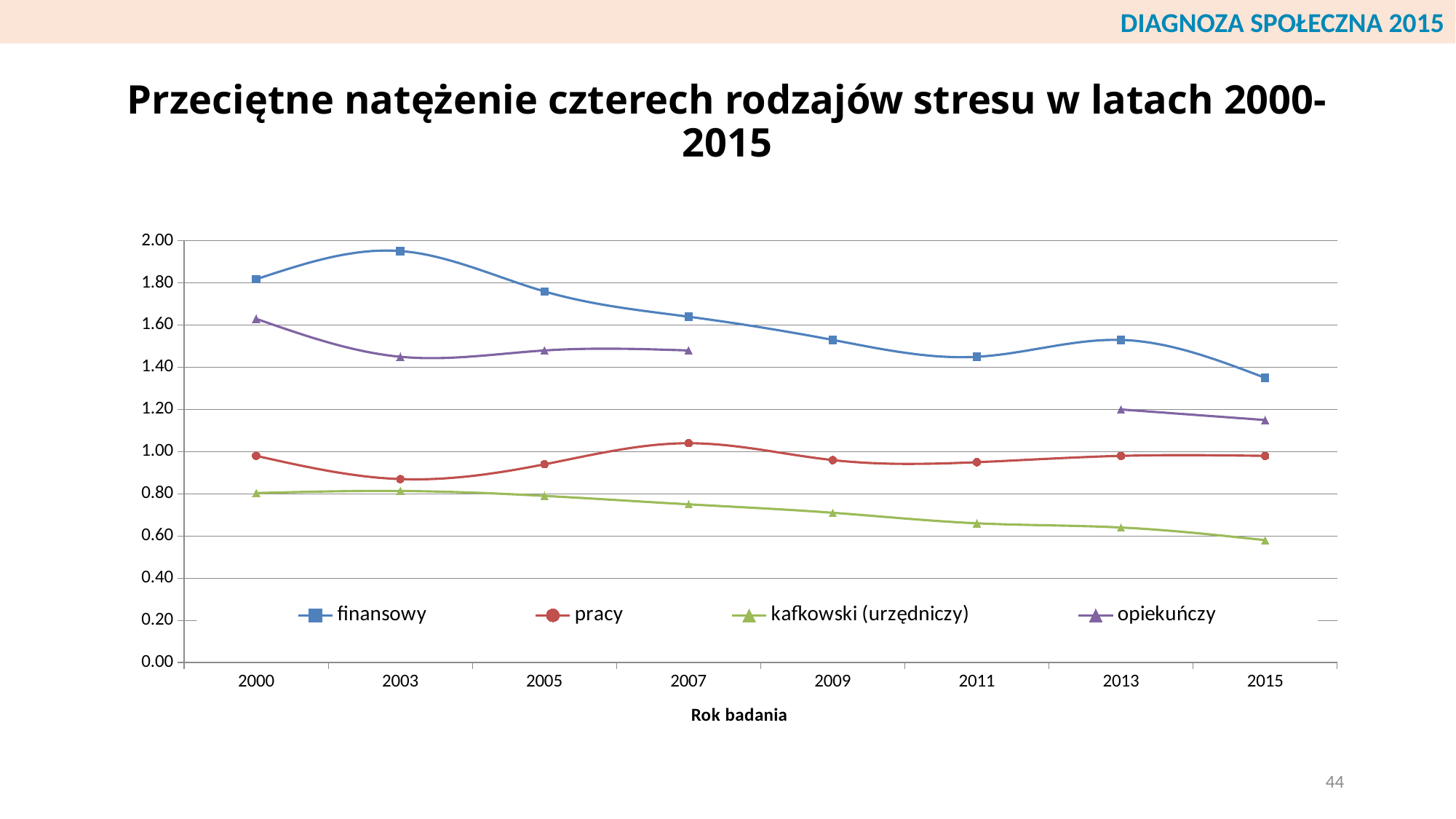
What is the title of the x axis? Rok badania Is the value for opiekuńczy in 2015 greater or less than 1.20? less Which series has the lowest value in 2015? kafkowski (urzędniczy) What kind of chart is shown on the slide? line chart Is the value for pracy in 2003 greater or less than 1.00? less Is the value for finansowy in 2003 greater or less than 1.80? greater Does the kafkowski (urzędniczy) series rise or fall from 2003 to 2015? fall How many survey years are shown on the x axis? 8 Which series has the highest value in 2000? finansowy How many series does the legend list? 4 Which is larger for the finansowy series: the value in 2000 or the value in 2015? 2000 In which year does the finansowy series reach its highest value? 2003